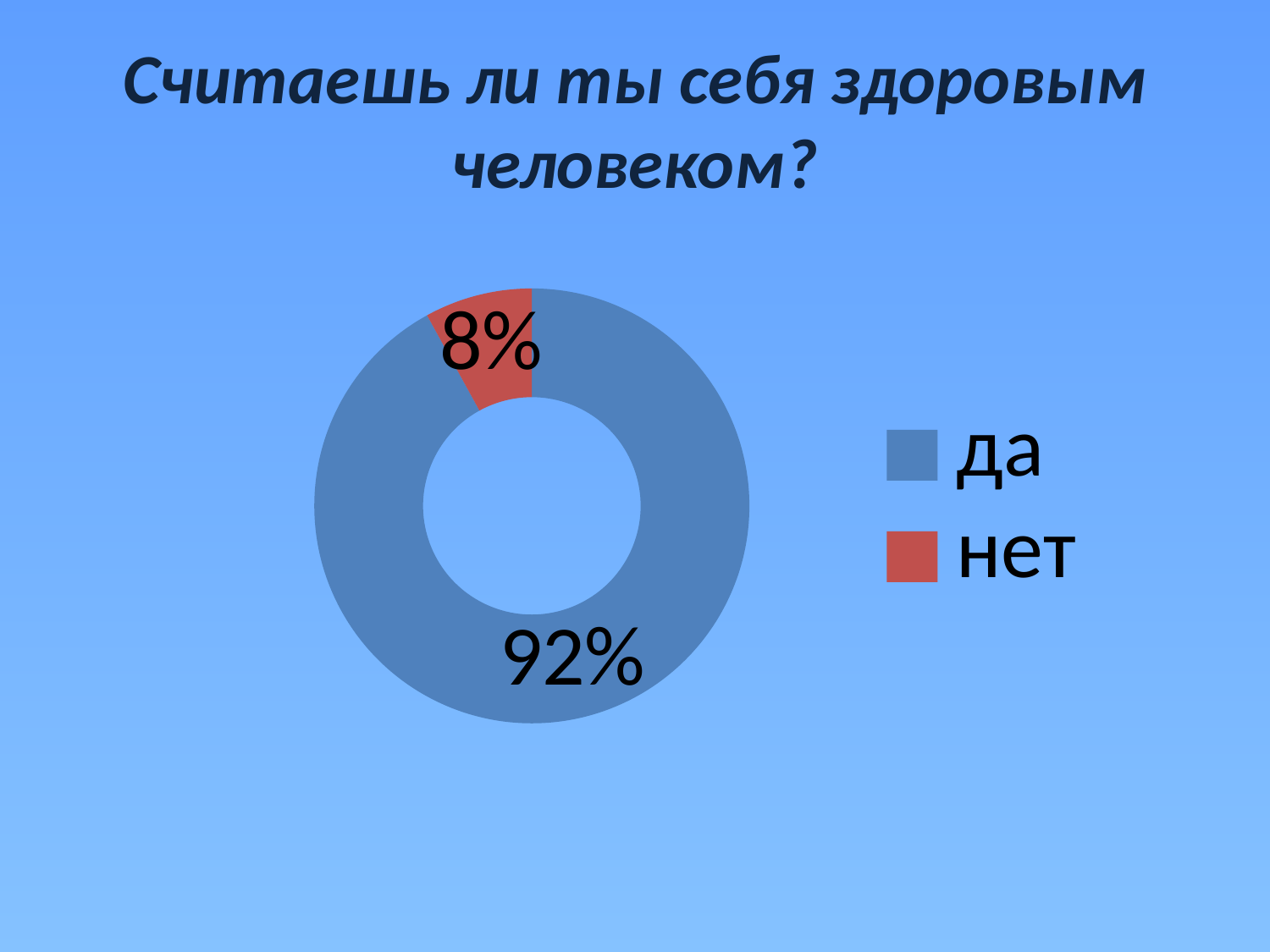
What kind of chart is shown on the slide? Doughnut (pie) chart What percentage of respondents answered "нет"? 8% What share of the chart does the "нет" slice represent? 8% What is the title of the slide above the chart? Считаешь ли ты себя здоровым человеком? What colour is the "нет" slice? Red Which answer has the smallest share of the chart? нет How many entries does the legend list? 2 What is the difference in percentage points between "да" and "нет"? 84 How many categories does the chart show? 2 Which answer has the largest share of the chart? да What percentage of respondents answered "да"? 92% Which is larger, the share for "да" or the share for "нет"? да